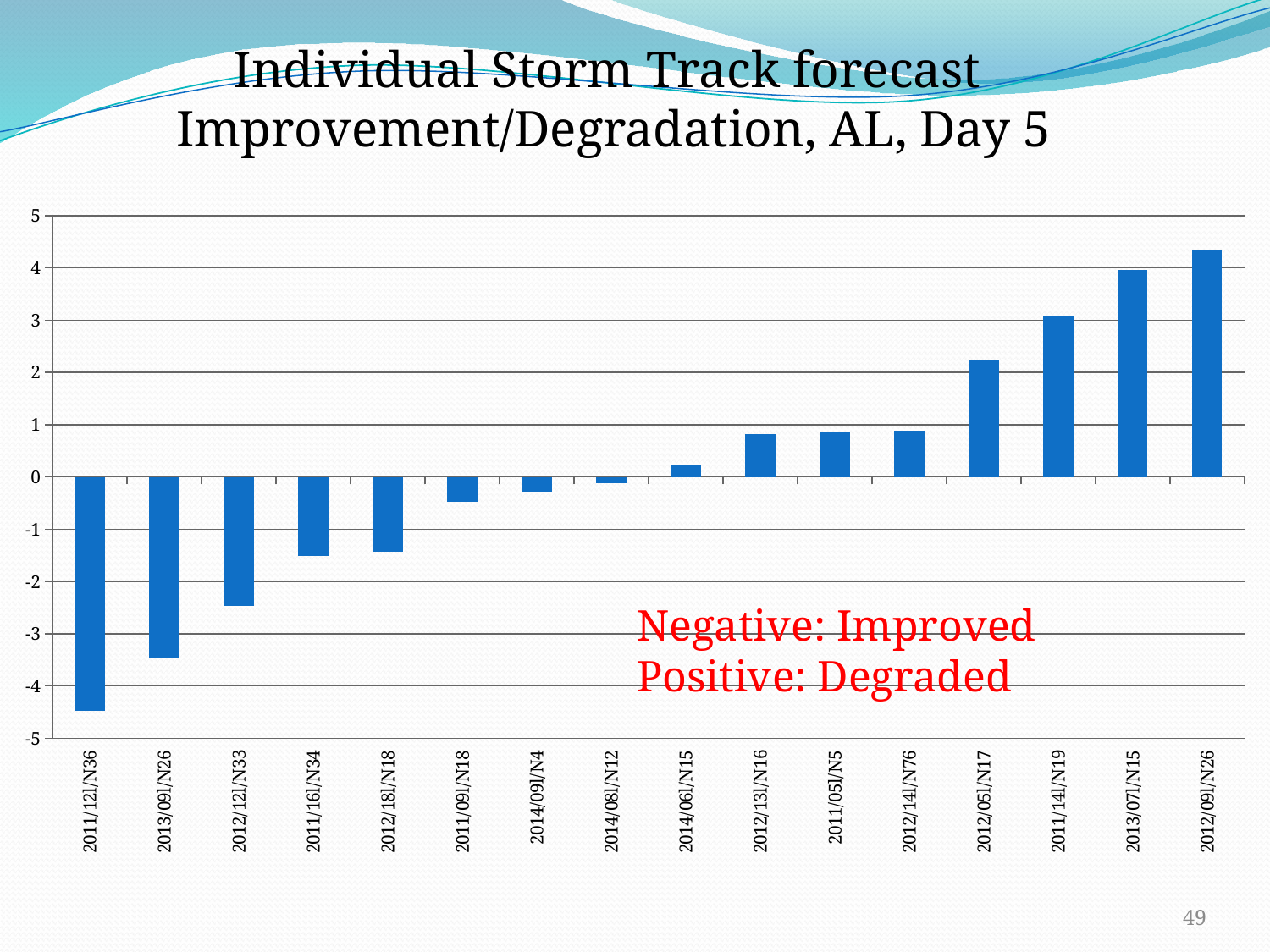
Do the bar values rise or fall moving from left to right along the x axis? rise Is the value for 2013/09l/N26 greater or less than -3? less Is the value for 2012/09l/N26 greater or less than 4? greater Which storm case has the highest value in the chart? 2012/09l/N26 According to the annotation on the chart, what does a negative value indicate? Improved Is the value for 2011/12l/N36 greater or less than -4? less Which storm case has the lowest value in the chart? 2011/12l/N36 How many storm cases (bars) are plotted in the chart? 16 Which has the larger value, 2011/14l/N19 or 2012/05l/N17? 2011/14l/N19 What kind of chart is shown on the slide? bar chart